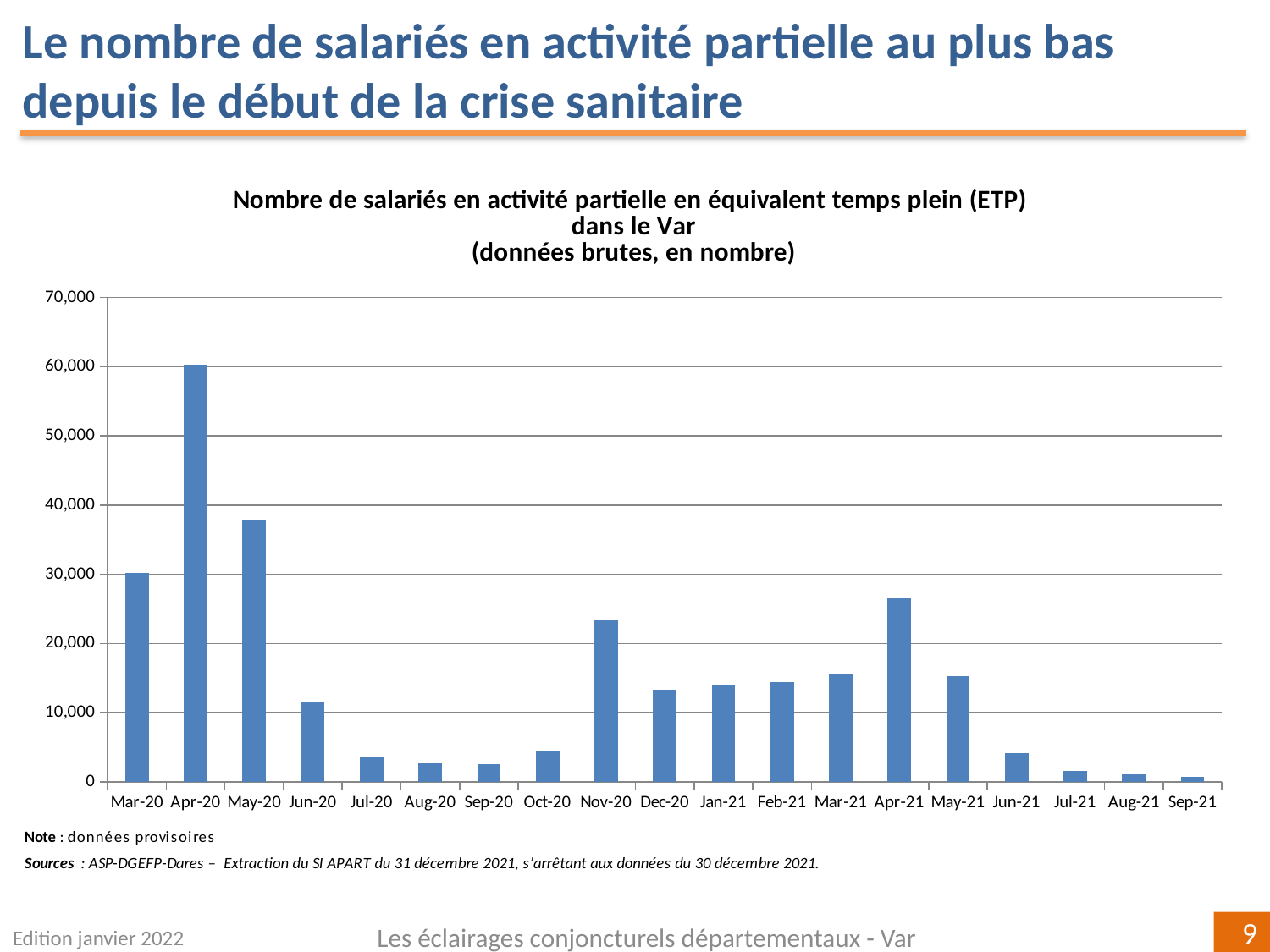
Which month has the highest number of salariés en activité partielle? Apr-20 Do the values rise or fall from Apr-20 to Sep-20? fall How many months (bars) are plotted on the chart? 19 Is the value for Apr-21 greater or less than 20,000? greater Which month has the lowest number of salariés en activité partielle? Sep-21 Is the value for Nov-20 greater or less than 20,000? greater What kind of chart is shown on the slide? bar chart What is the title of the chart? Nombre de salariés en activité partielle en équivalent temps plein (ETP) dans le Var (données brutes, en nombre) Is the value for Apr-20 greater or less than 50,000? greater Which is larger, the value for Apr-21 or the value for Nov-20? Apr-21